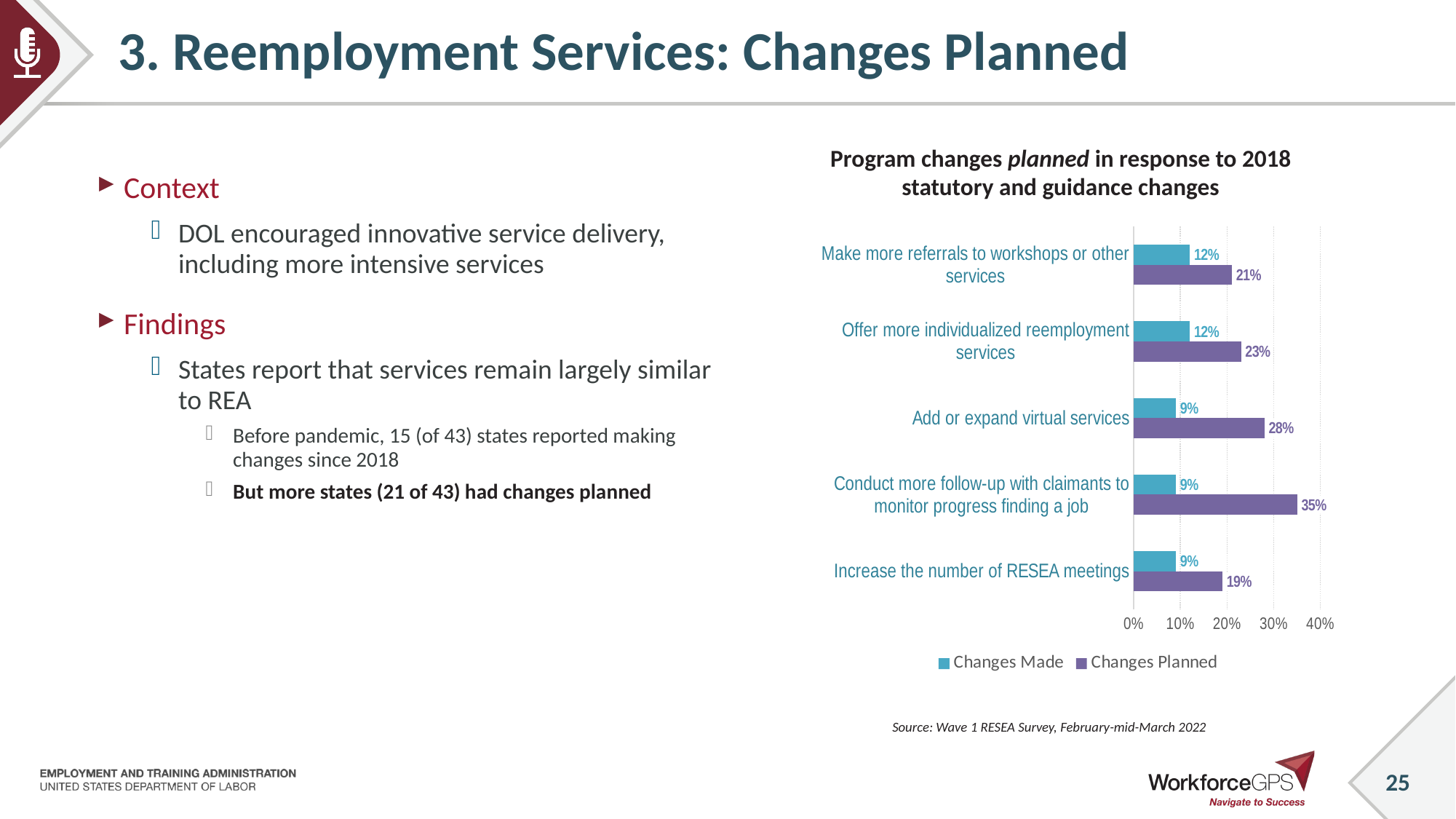
What is the difference between Changes Planned and Changes Made for "Add or expand virtual services"? 19% How many series does the legend list? 2 What is the Changes Planned value for "Increase the number of RESEA meetings"? 19% How many categories are shown in the chart? 5 What kind of chart is shown on the slide? Bar chart Which category has the highest Changes Planned value? Conduct more follow-up with claimants to monitor progress finding a job Which is larger: the Changes Planned value for "Offer more individualized reemployment services" or for "Make more referrals to workshops or other services"? Offer more individualized reemployment services What are the two series named in the chart legend? Changes Made and Changes Planned What is the Changes Made value for "Add or expand virtual services"? 9% Which category has the lowest Changes Planned value? Increase the number of RESEA meetings Is the Changes Planned value for "Conduct more follow-up with claimants to monitor progress finding a job" greater or less than 30%? greater What is the Changes Planned value for "Conduct more follow-up with claimants to monitor progress finding a job"? 35%